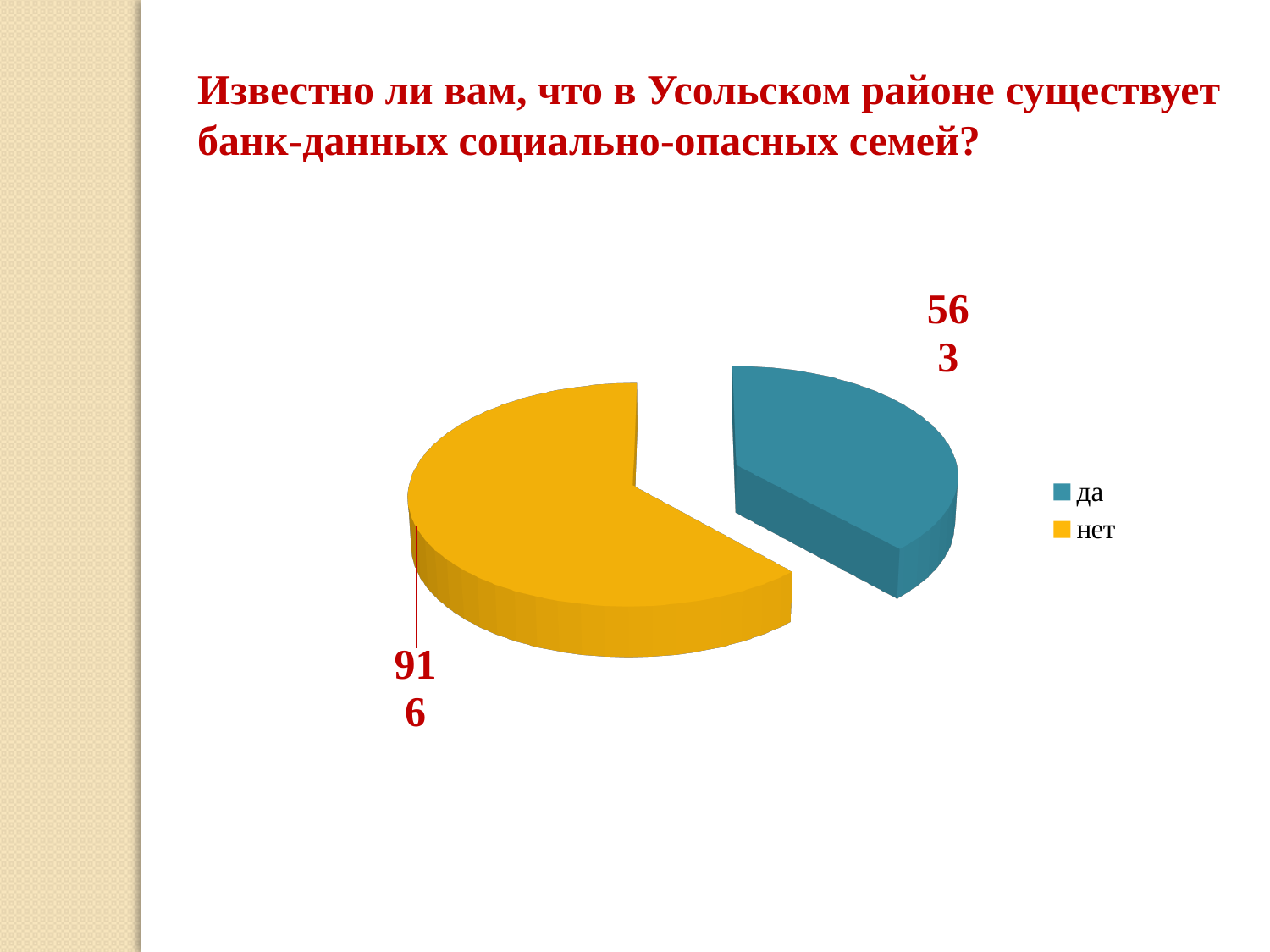
What is the total of the two values shown on the pie chart? 1479 Which is larger, the value for "да" or the value for "нет"? нет What kind of chart is shown on the slide? pie chart How many entries does the legend list? 2 What colour is the slice for "да"? blue Which category has the largest slice? нет What is the value for "да"? 563 What is the value for "нет"? 916 What is the difference between the value for "нет" and the value for "да"? 353 Which category has the smallest slice? да What colour is the slice for "нет"? yellow How many slices does the pie chart have? 2